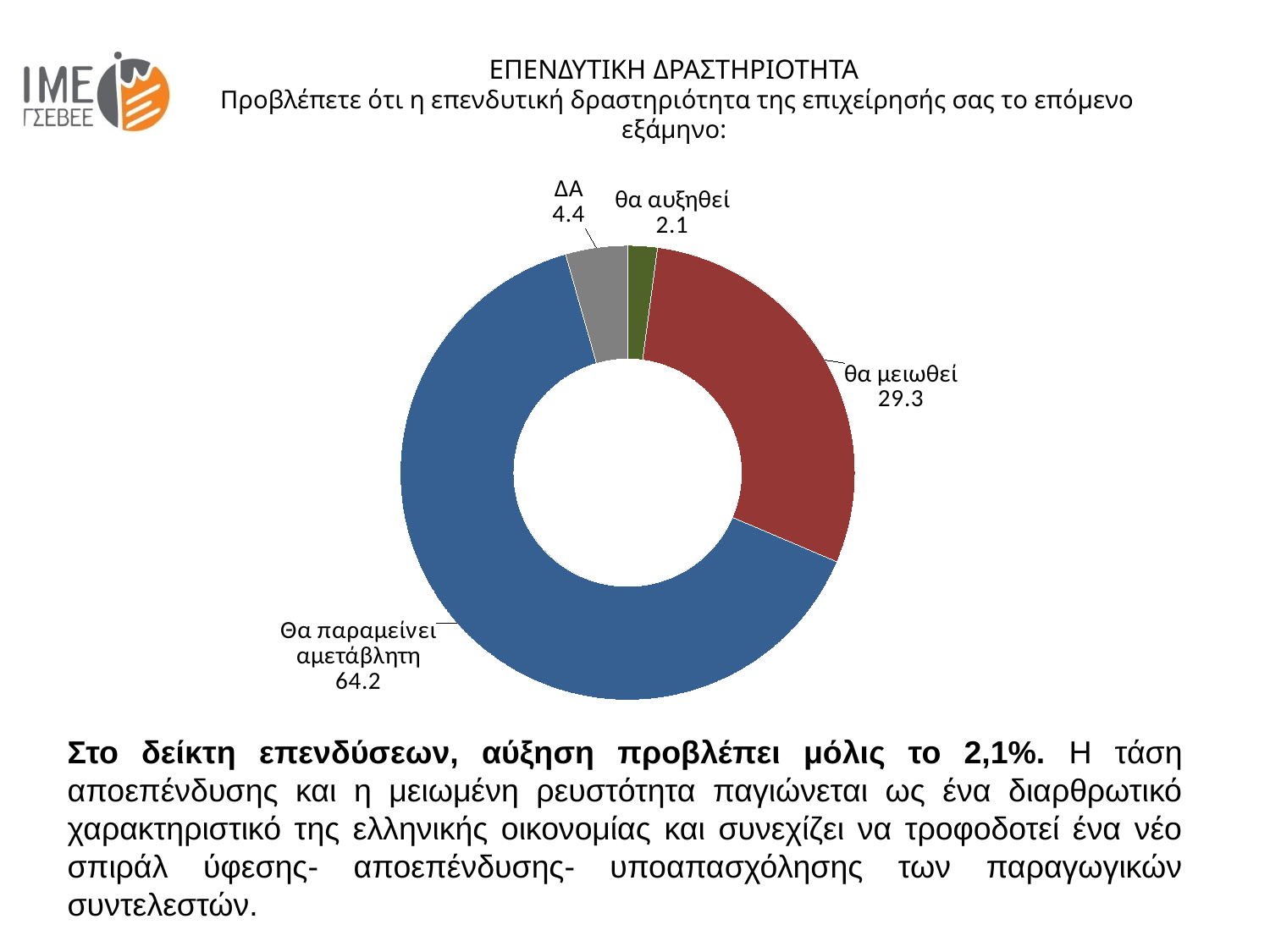
What value is shown for the slice labelled "ΔΑ"? 4.4 What kind of chart is shown on the slide? Doughnut (pie) chart How many slices does the chart have? 4 What value is shown for the slice labelled "Θα παραμείνει αμετάβλητη"? 64.2 What value is shown for the slice labelled "θα μειωθεί"? 29.3 What is the difference between the values for "θα μειωθεί" and "ΔΑ"? 24.9 Which is larger, the value for "ΔΑ" or the value for "θα αυξηθεί"? ΔΑ What value is shown for the slice labelled "θα αυξηθεί"? 2.1 Which category has the largest slice? Θα παραμείνει αμετάβλητη What colour is the slice for "θα μειωθεί"? Red What is the difference between the values for "Θα παραμείνει αμετάβλητη" and "θα μειωθεί"? 34.9 Which category has the smallest slice? θα αυξηθεί